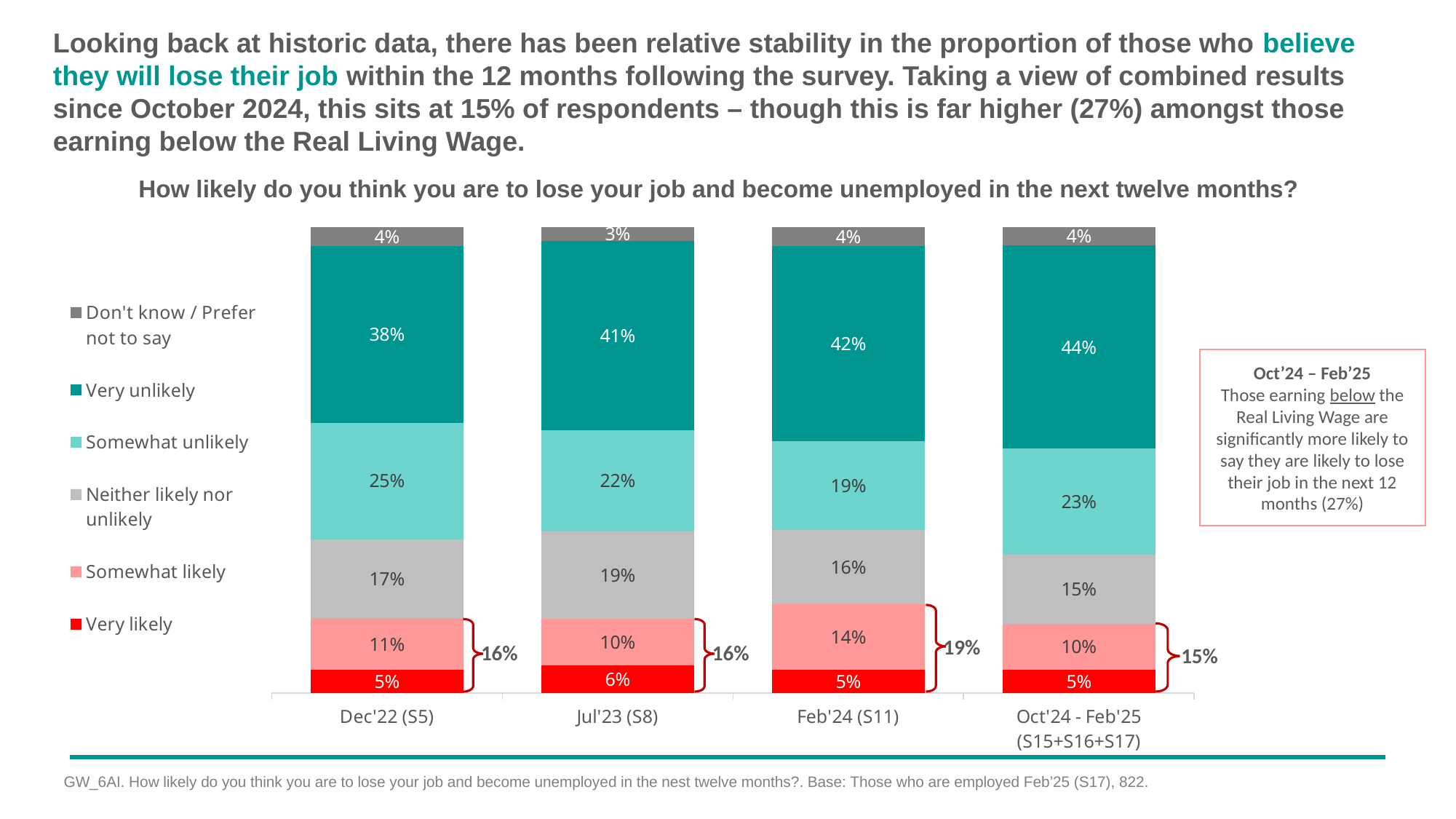
What percentage of respondents said 'Very likely' in Jul'23 (S8)? 6% What is the combined 'Very likely' and 'Somewhat likely' percentage shown by the bracket for Feb'24 (S11)? 19% What type of chart is shown on the slide? Stacked bar chart Which survey wave has the lowest 'Somewhat unlikely' percentage? Feb'24 (S11) What percentage of respondents said 'Somewhat likely' in Feb'24 (S11)? 14% Which survey wave has the highest 'Very unlikely' percentage? Oct'24 - Feb'25 (S15+S16+S17) Which is larger: the 'Neither likely nor unlikely' percentage in Jul'23 (S8) or in Oct'24 - Feb'25 (S15+S16+S17)? Jul'23 (S8) How many response categories does the legend list? 6 What percentage of respondents said 'Very unlikely' in the Oct'24 - Feb'25 (S15+S16+S17) bar? 44% How many survey waves (bars) are shown in the chart? 4 What percentage of respondents said 'Neither likely nor unlikely' in Dec'22 (S5)? 17% What is the difference between the 'Somewhat unlikely' percentage in Dec'22 (S5) and in Feb'24 (S11)? 6 percentage points